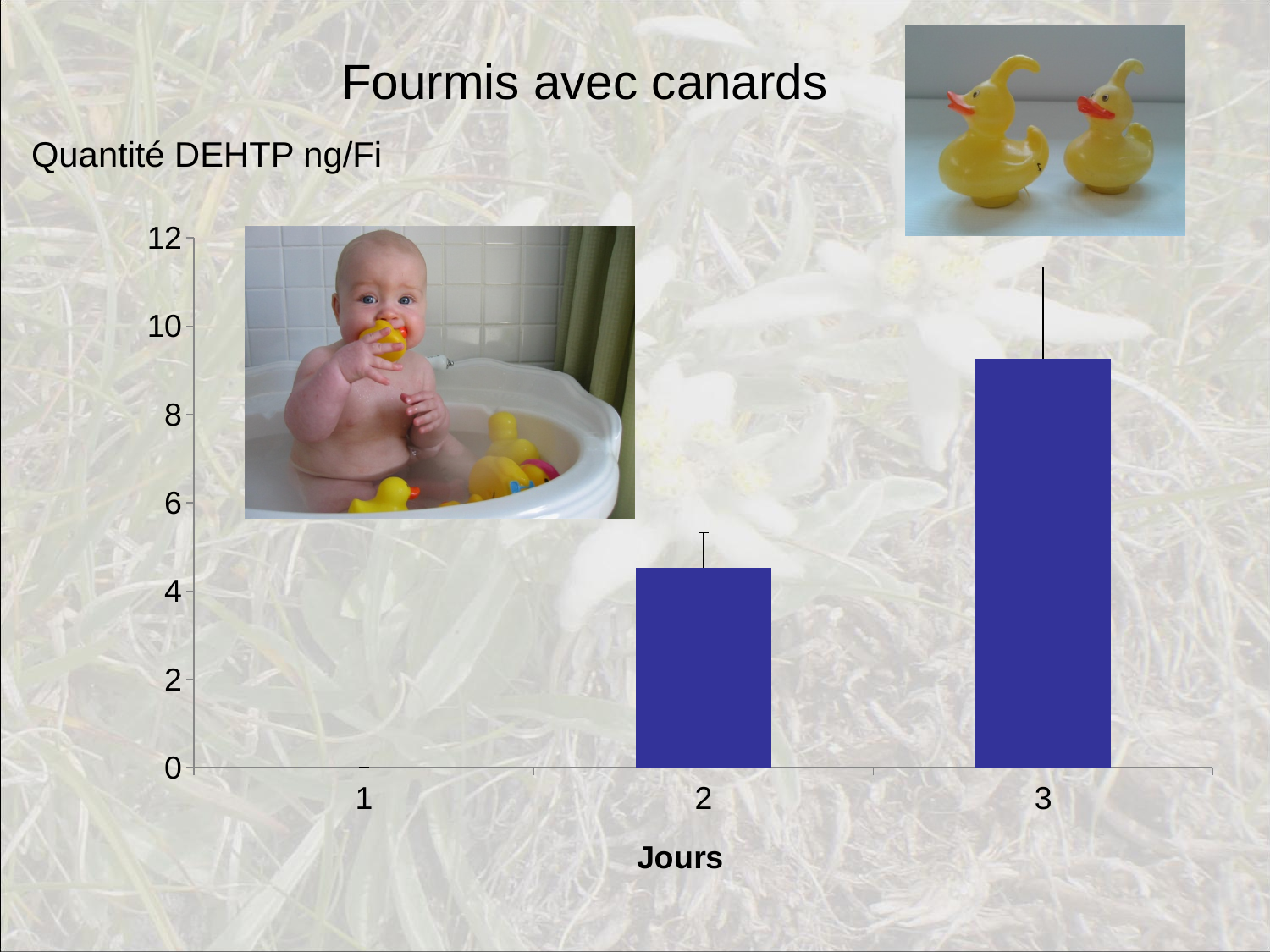
Is the value for day 2 greater or less than 4? greater Is the value for day 3 greater or less than 10? less How many categories (days) are shown on the x axis? 3 Which day has the highest quantity of DEHTP? 3 Is the value for day 3 greater or less than 8? greater Which has a larger value, day 2 or day 3? 3 Which day has the lowest quantity of DEHTP? 1 What is the title of the chart? Fourmis avec canards Do the values rise or fall from day 1 to day 3? rise What is the label of the x axis? Jours What kind of chart is shown on the slide? bar chart